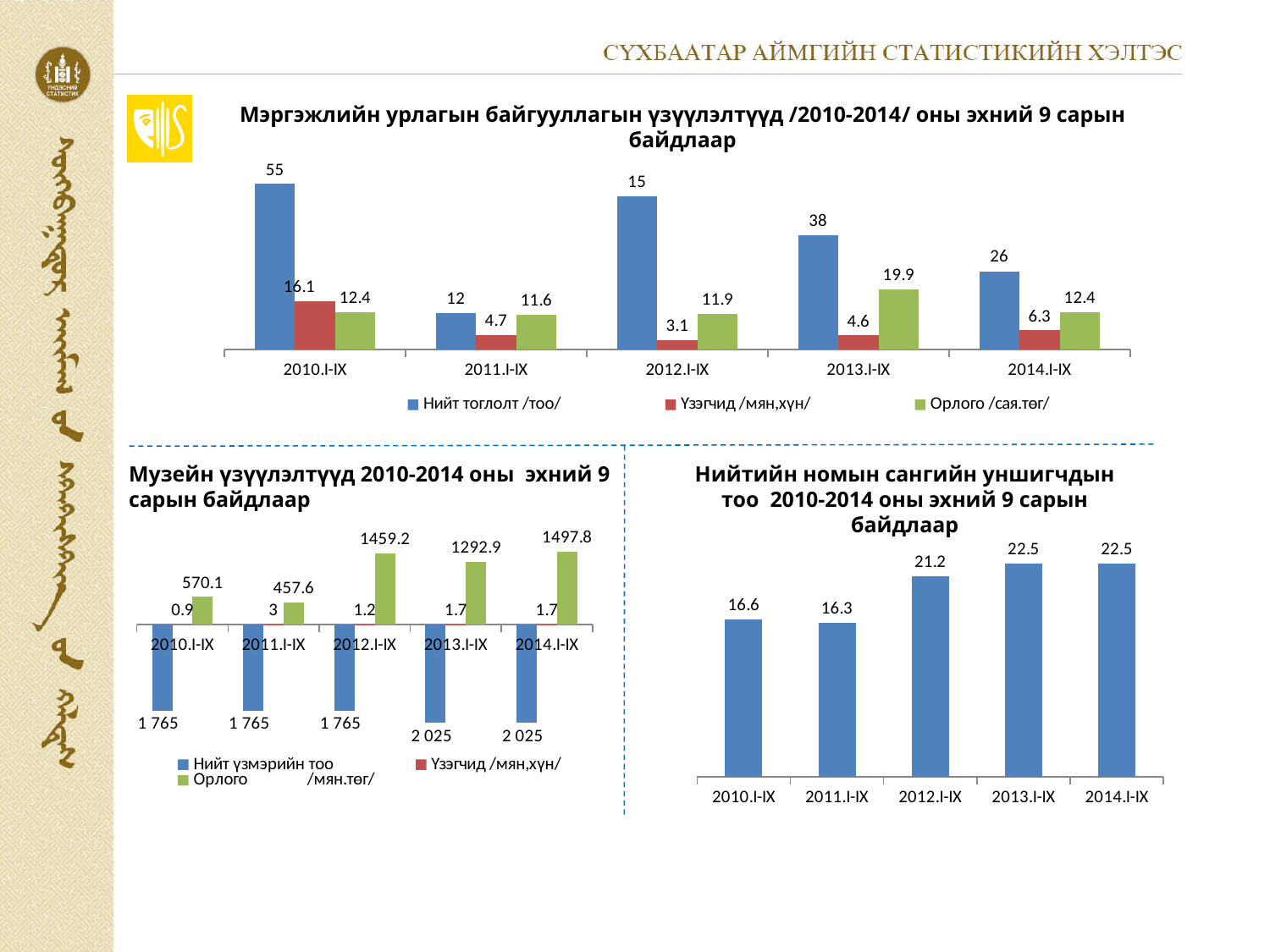
In the top chart 'Мэргэжлийн урлагын байгууллагын үзүүлэлтүүд', what is the value of Орлого /сая.төг/ for 2013.I-IX? 19.9 In the top chart 'Мэргэжлийн урлагын байгууллагын үзүүлэлтүүд', what is the difference between Үзэгчид /мян.хүн/ in 2010.I-IX and 2014.I-IX? 9.8 In the bottom-left chart 'Музейн үзүүлэлтүүд', is Орлого /мян.төг/ larger in 2010.I-IX or 2011.I-IX? 2010.I-IX In the bottom-left chart 'Музейн үзүүлэлтүүд', what is the value of Орлого /мян.төг/ for 2012.I-IX? 1459.2 In the bottom-left chart 'Музейн үзүүлэлтүүд', which period has the highest value for Орлого /мян.төг/? 2014.I-IX In the bottom-right chart 'Нийтийн номын сангийн уншигчдын тоо', which period has the lowest value? 2011.I-IX In the top chart 'Мэргэжлийн урлагын байгууллагын үзүүлэлтүүд', which period has the lowest value for Үзэгчид /мян.хүн/? 2012.I-IX What kind of chart is the bottom-right chart 'Нийтийн номын сангийн уншигчдын тоо'? Bar chart In the top chart 'Мэргэжлийн урлагын байгууллагын үзүүлэлтүүд', what is the value of Нийт тоглолт /тоо/ for 2010.I-IX? 55 In the bottom-right chart 'Нийтийн номын сангийн уншигчдын тоо', what is the value for 2012.I-IX? 21.2 In the bottom-left chart 'Музейн үзүүлэлтүүд', what is the value of Нийт үзмэрийн тоо for 2013.I-IX? 2 025 How many series does the legend of the top chart 'Мэргэжлийн урлагын байгууллагын үзүүлэлтүүд' list? 3